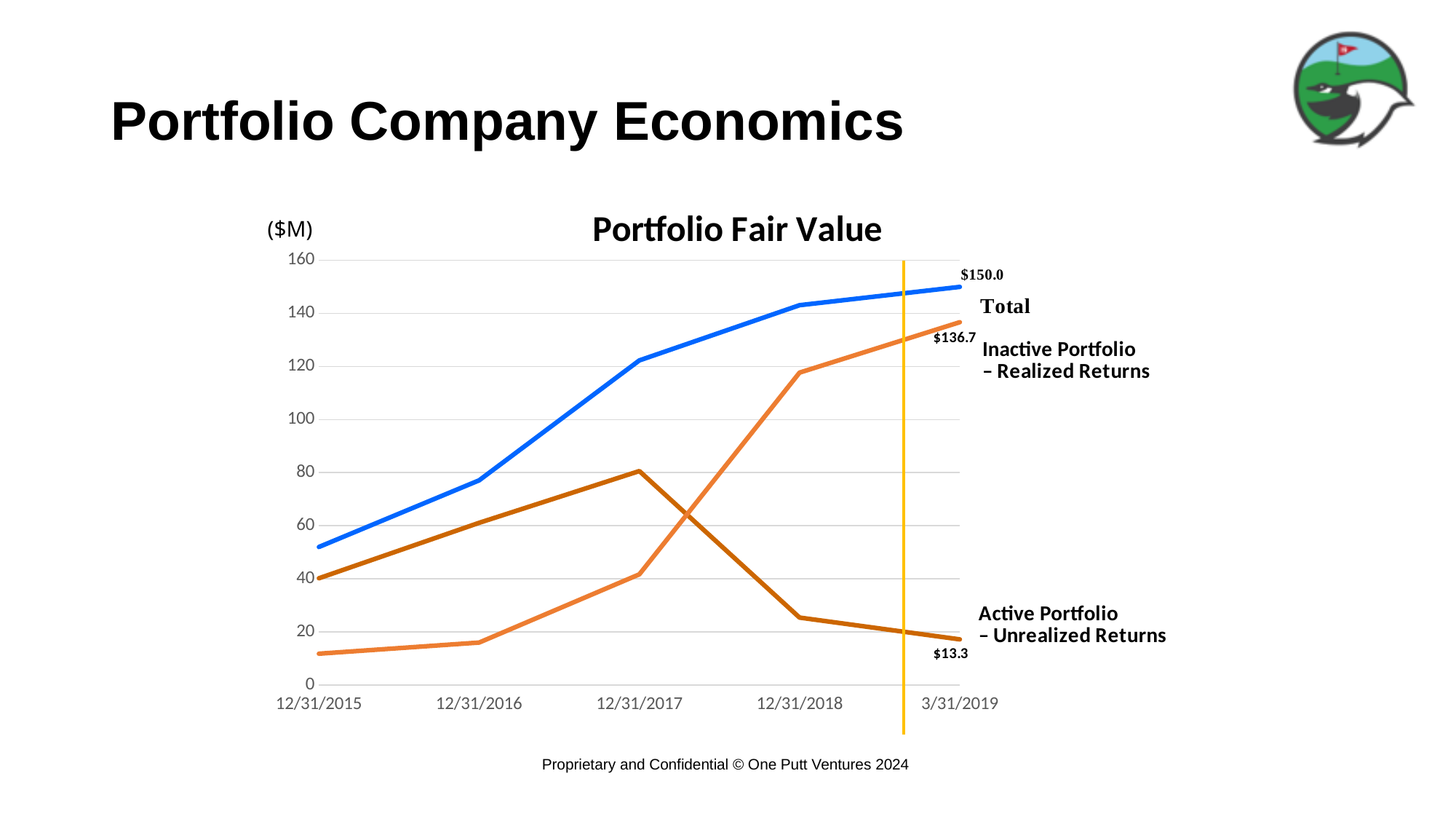
What is the difference between the Total and the Inactive Portfolio – Realized Returns values at 3/31/2019? $13.3 What is the value of the Total series at 3/31/2019? $150.0 At 12/31/2016, which is larger: the Active Portfolio – Unrealized Returns value or the Inactive Portfolio – Realized Returns value? Active Portfolio – Unrealized Returns What is the value of the Active Portfolio – Unrealized Returns series at 3/31/2019? $13.3 Is the value of the Inactive Portfolio – Realized Returns series at 12/31/2018 greater or less than 100? greater How many series are plotted on the chart? 3 What unit is shown for the y axis of the chart? ($M) Does the Active Portfolio – Unrealized Returns series rise or fall from 12/31/2017 to 3/31/2019? fall What is the value of the Inactive Portfolio – Realized Returns series at 3/31/2019? $136.7 How many dates are shown on the x axis? 5 What kind of chart is shown on the slide? line chart Does the Total series rise or fall from 12/31/2015 to 3/31/2019? rise